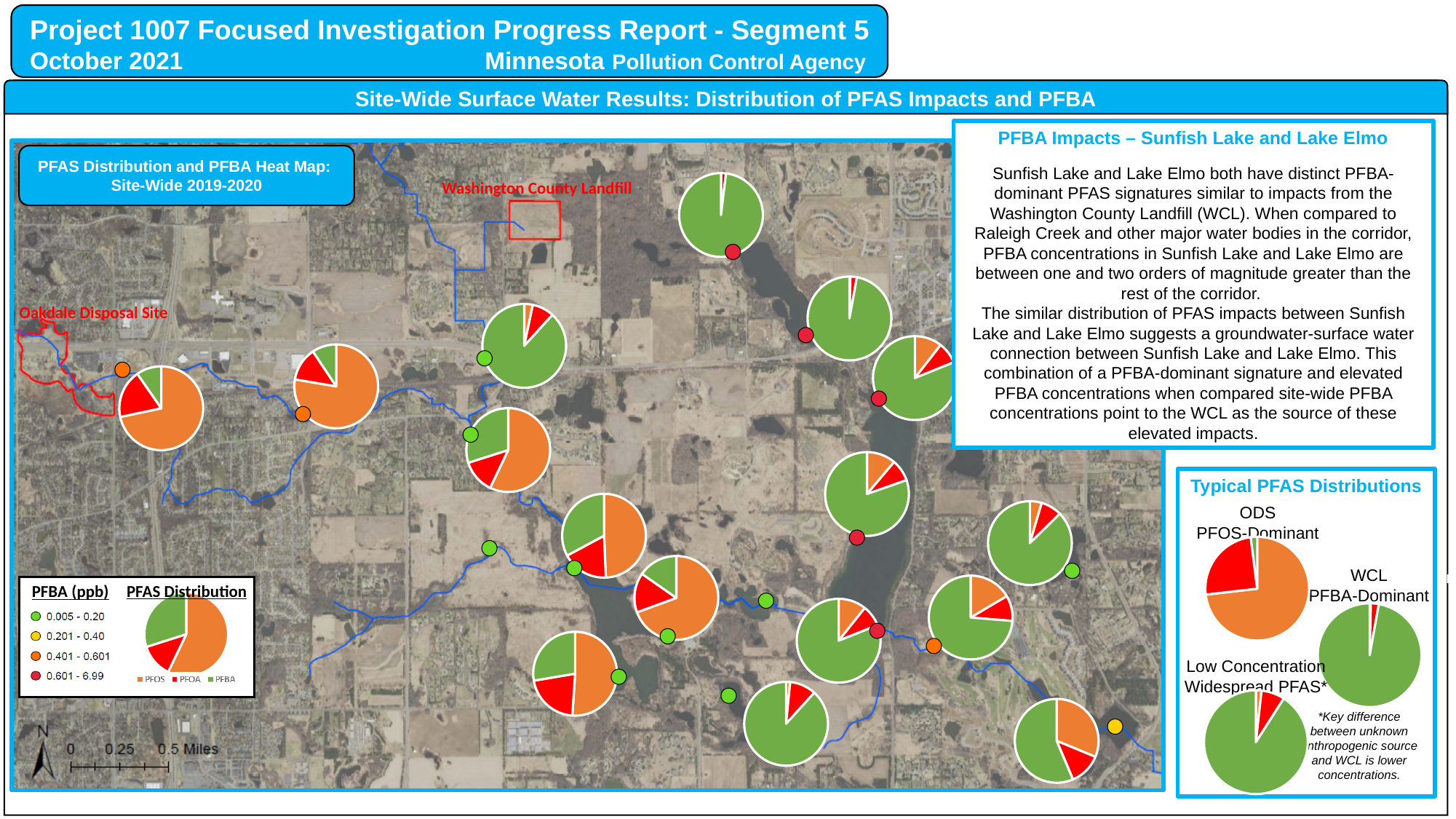
In the ODS PFOS-Dominant pie chart, which series has the smallest slice? PFBA In the Typical PFAS Distributions panel, which series has the largest slice in the ODS PFOS-Dominant pie chart? PFOS How many pie charts are shown in the Typical PFAS Distributions panel? 3 How many series does the PFAS Distribution legend list? 3 What colour represents PFBA in the pie charts? Green What kind of charts are used on the map to show the PFAS distribution at each sampling location? Pie charts Which series are listed in the PFAS Distribution legend? PFOS, PFOA, PFBA In the Typical PFAS Distributions panel, which series has the largest slice in the WCL PFBA-Dominant pie chart? PFBA In the ODS PFOS-Dominant pie chart, which slice is larger, PFOS or PFOA? PFOS How many PFBA (ppb) concentration ranges are listed in the map legend? 4 In the Typical PFAS Distributions panel, which series has the largest slice in the Low Concentration Widespread PFAS pie chart? PFBA In the WCL PFBA-Dominant pie chart, which slice is larger, PFBA or PFOA? PFBA